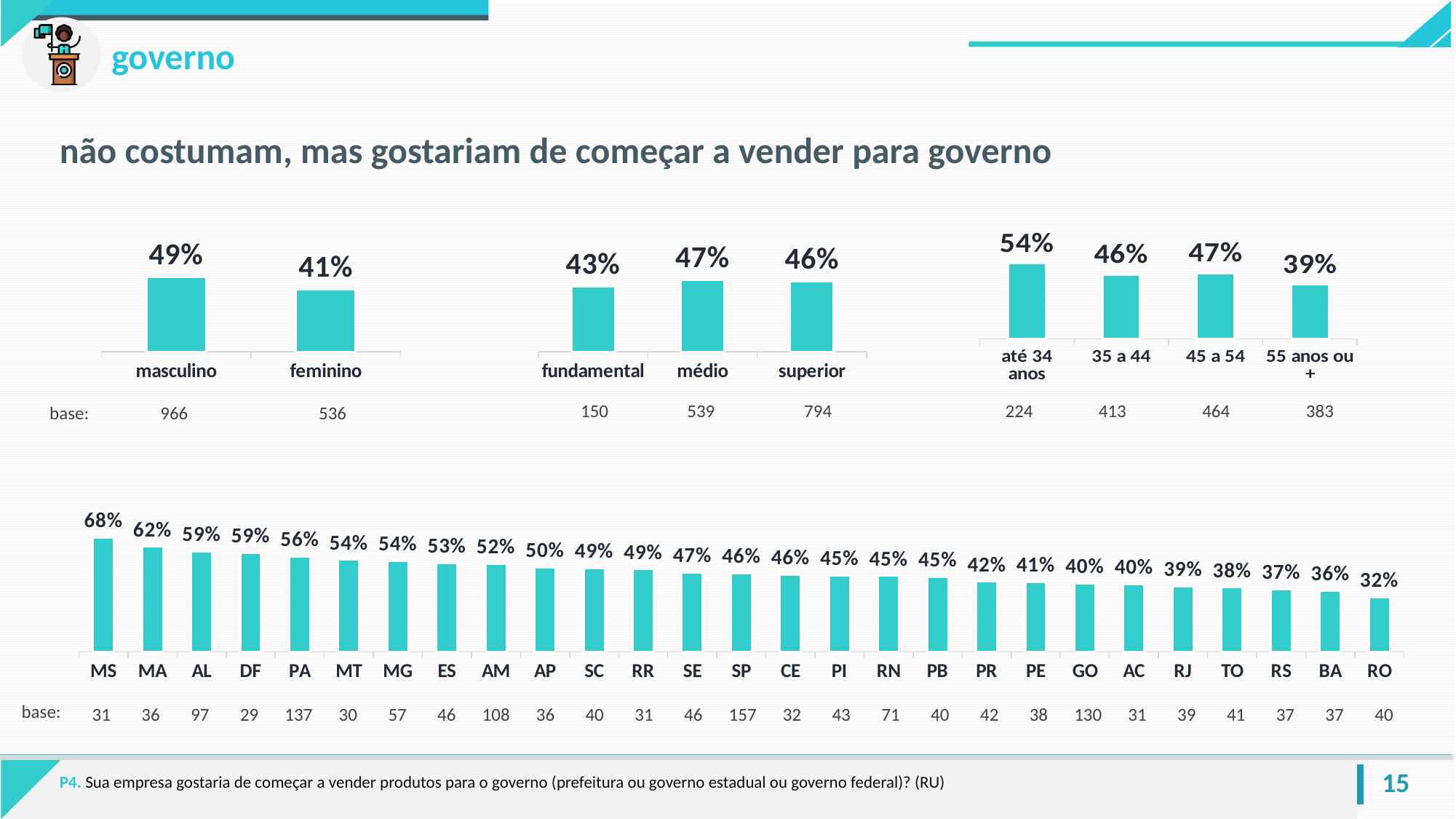
In the top-left chart (masculino/feminino), what is the difference between masculino and feminino? 8% In the top-middle chart (education level), what is the value for fundamental? 43% In the bottom chart (by state), what is the value for SP? 46% In the top-right chart (age groups), which age group has the lowest value? 55 anos ou + In the top-middle chart (education level), which category has the highest value? médio In the top-left chart (masculino/feminino), what is the value for masculino? 49% What kind of chart is the bottom chart (by state)? bar chart In the bottom chart (by state), how many states are shown? 27 In the bottom chart (by state), which state has the highest value? MS In the top-right chart (age groups), how many categories are shown? 4 In the top-right chart (age groups), what is the value for até 34 anos? 54% In the bottom chart (by state), which state has the lowest value? RO